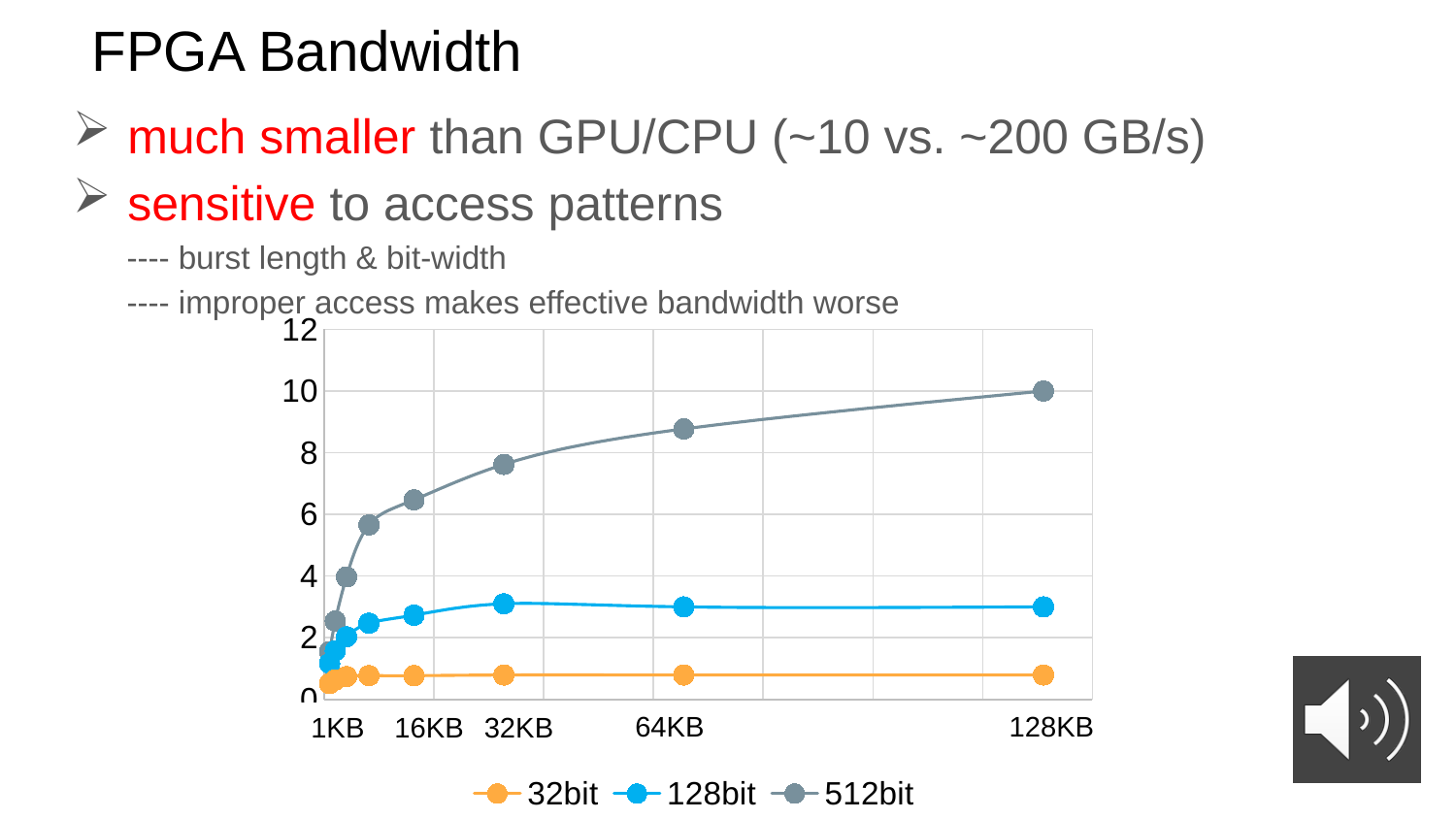
What are the three series named in the legend? 32bit, 128bit, 512bit Is the value for 128bit at 128KB greater or less than 4? less What is the highest tick value shown on the y axis? 12 Which series has the lowest value at 64KB? 32bit Is the value for 32bit at 64KB greater or less than 2? less Which series has the highest value at 128KB? 512bit Is the value for 512bit at 32KB greater or less than 6? greater Does the 512bit series rise or fall as the x axis goes from 1KB to 128KB? rise How many series does the legend list? 3 At 64KB, which series has the larger value, 512bit or 128bit? 512bit What kind of chart is shown on the slide? line chart